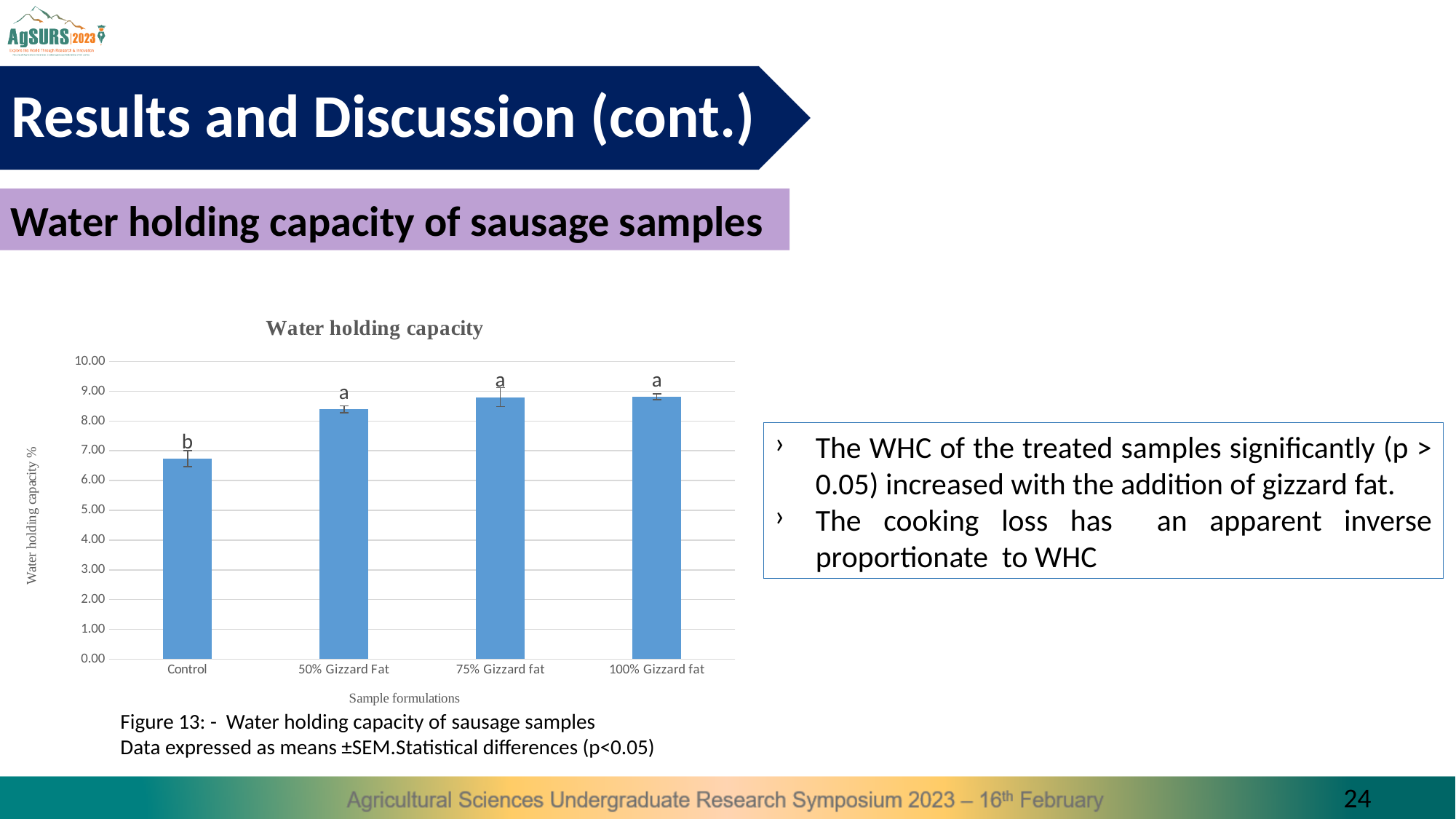
What is the title of the chart? Water holding capacity Is the water holding capacity for 100% Gizzard fat greater or less than 9.00? less Which sample formulation has the lowest water holding capacity? Control Which has the higher water holding capacity, Control or 50% Gizzard Fat? 50% Gizzard Fat Is the water holding capacity for 75% Gizzard fat greater or less than 8.00? greater Which has the higher water holding capacity, Control or 100% Gizzard fat? 100% Gizzard fat Is the water holding capacity for 50% Gizzard Fat greater or less than 8.00? greater How many sample formulations are plotted on the x axis of the chart? 4 Do the bar values generally rise or fall from Control to 100% Gizzard fat along the x axis? rise What is the label of the x axis of the chart? Sample formulations What kind of chart is shown on the slide? bar chart